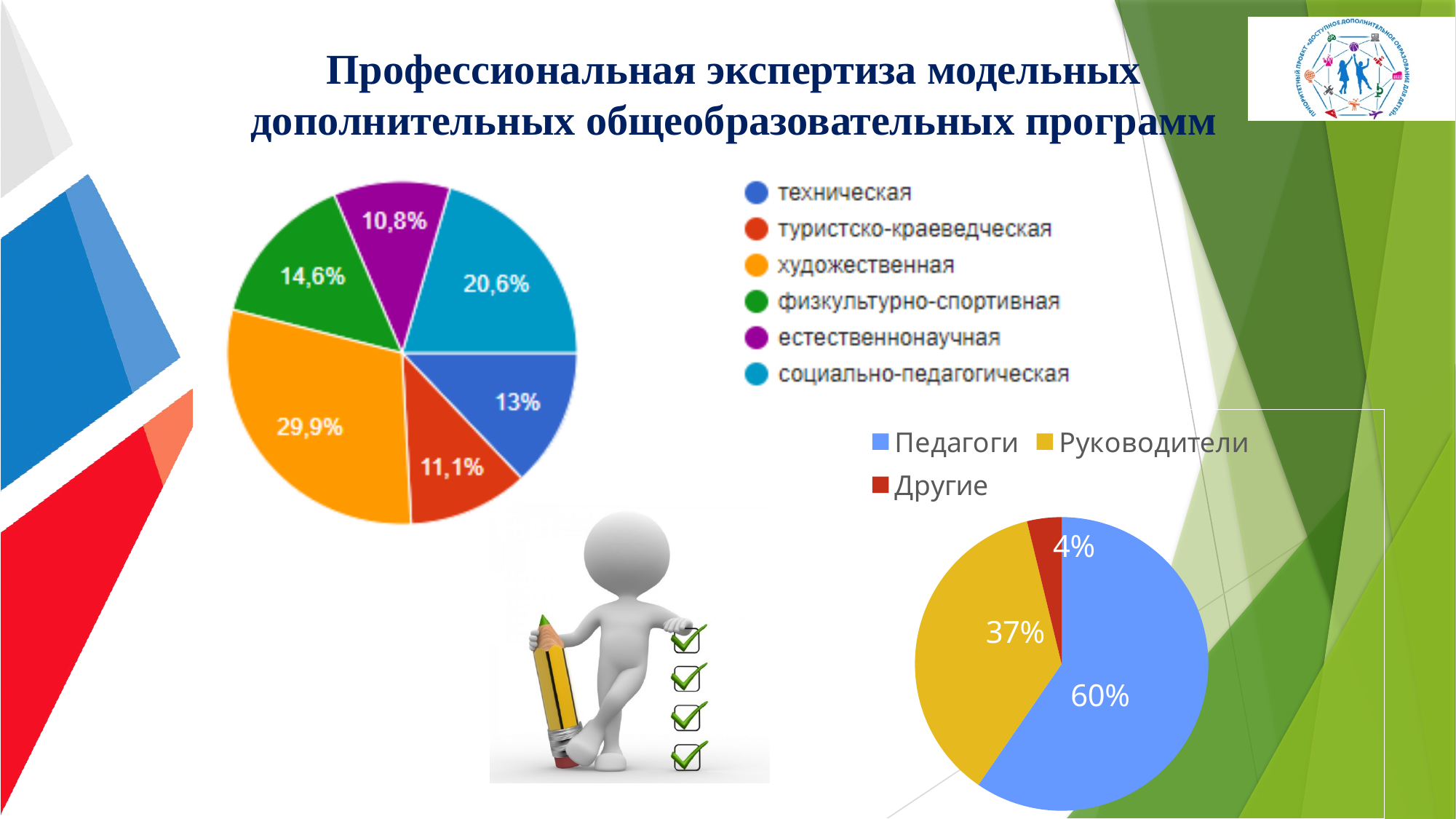
On the left pie chart, which category has the largest share? художественная On the left pie chart, what share does социально-педагогическая have? 20,6% On the right pie chart, which category has the largest share? Педагоги What type of chart is the chart in the lower right of the slide? Pie chart On the left pie chart, which is larger: техническая or социально-педагогическая? социально-педагогическая On the right pie chart, what is the difference between the shares of Педагоги and Другие? 56% On the left pie chart, what share does естественнонаучная have? 10,8% On the left pie chart, which category has the smallest share? естественнонаучная On the left pie chart, what share does художественная have? 29,9% On the left pie chart, what is the difference between the shares of физкультурно-спортивная and туристско-краеведческая? 3,5% How many categories does the left pie chart show? 6 On the right pie chart, what share do Руководители have? 37%